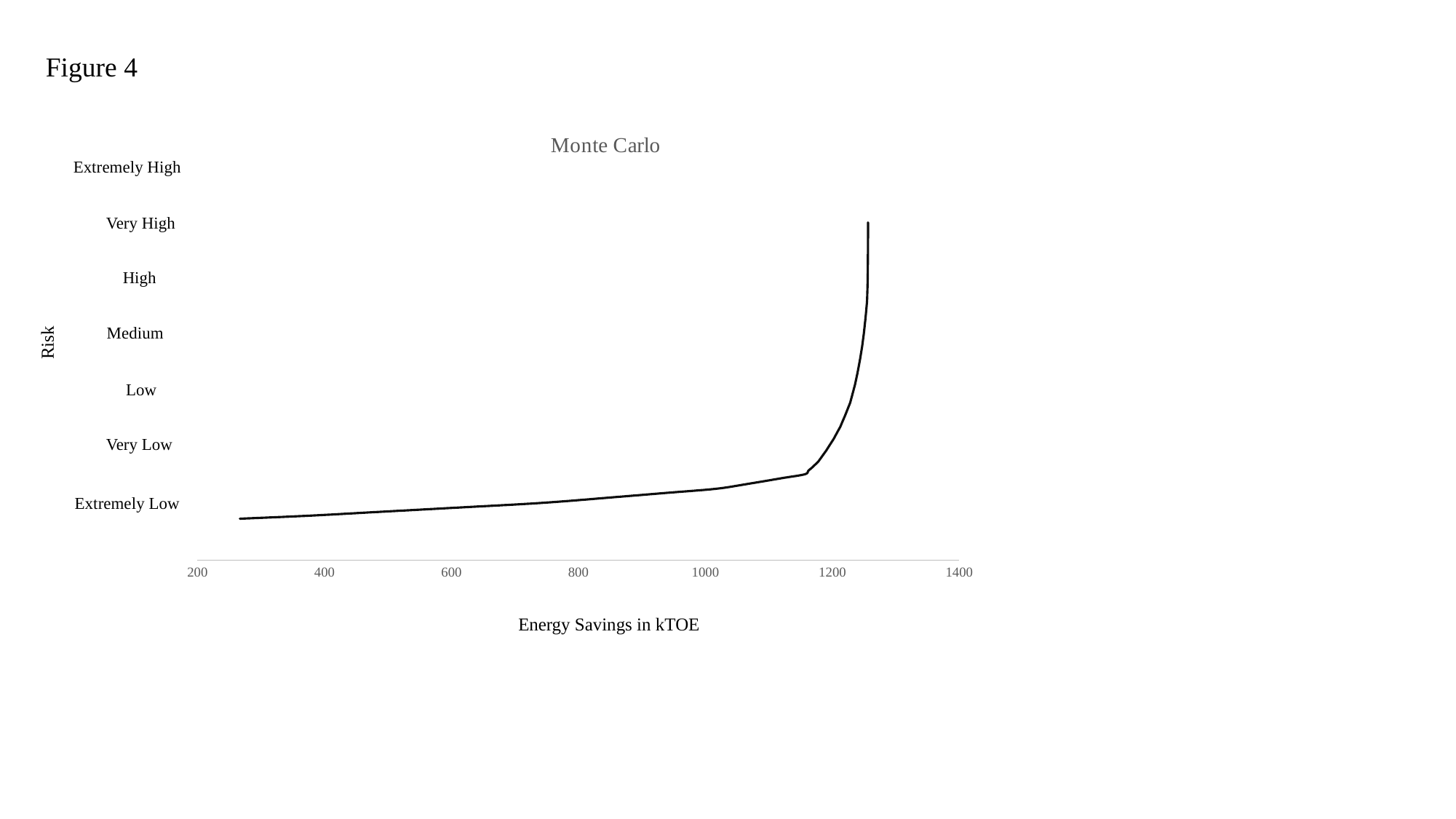
Does the risk level rise or fall as energy savings increase along the x axis? Rise What is the label of the horizontal axis? Energy Savings in kTOE Which risk level does the curve start at its lowest point? Extremely Low What kind of chart is shown on the slide? Line chart Is the risk at 1200 kTOE higher or lower than the risk at 600 kTOE? Higher What is the title of the chart? Monte Carlo How many risk levels are labelled on the vertical axis? 7 Is the energy savings value at the top end of the curve greater or less than 1200? greater Is the energy savings value at the lowest point of the curve greater or less than 400? less Is the energy savings value where the curve reaches the Very Low risk level greater or less than 1000? greater Which risk level does the curve reach at its highest point? Very High What is the highest value shown on the horizontal axis? 1400